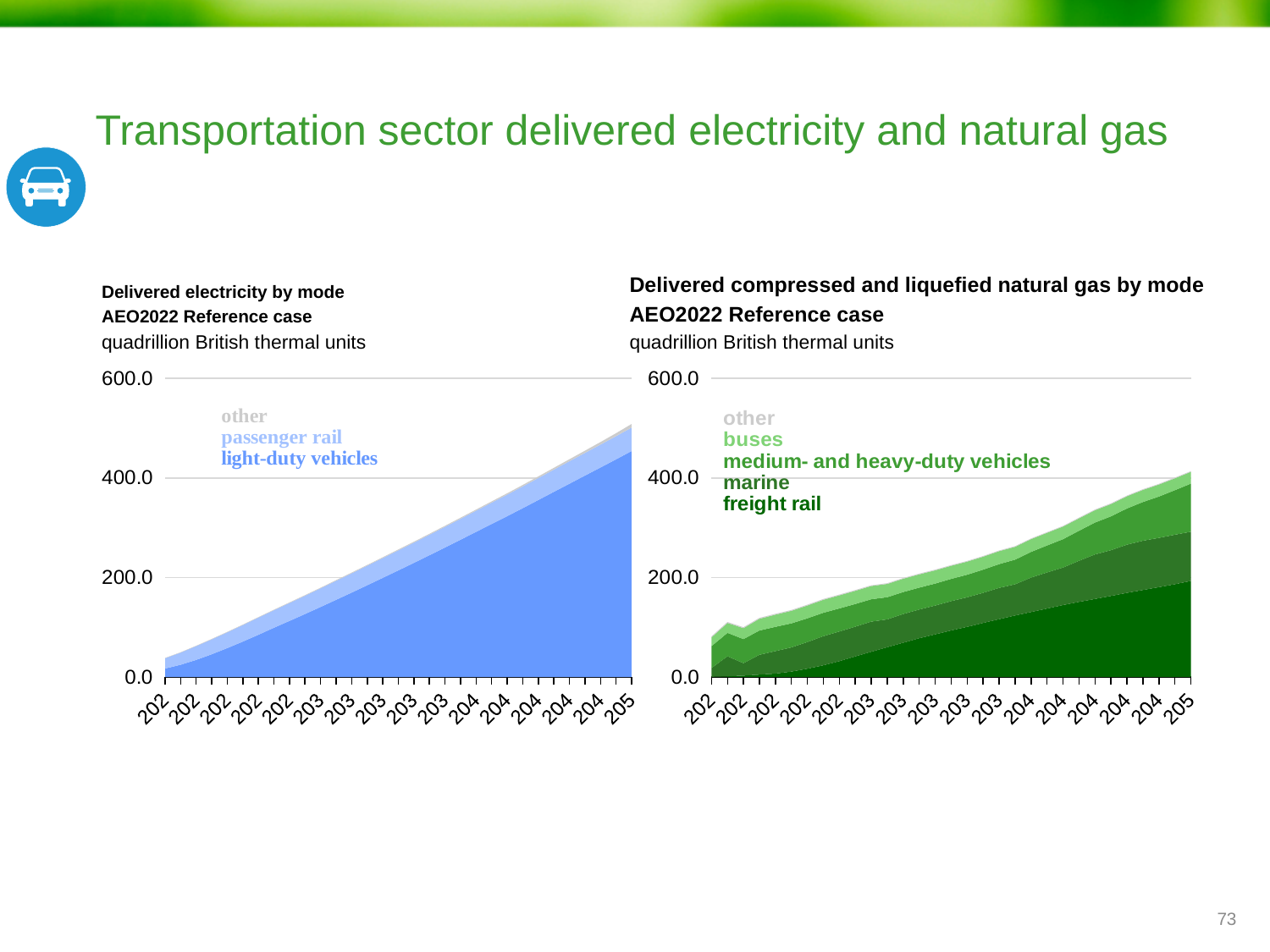
What kind of chart is the 'Delivered compressed and liquefied natural gas by mode' chart on the right? Stacked area chart In the left chart, 'Delivered electricity by mode', is the total at the final year greater or less than 400.0? greater In the left chart, 'Delivered electricity by mode', is the total at the first year greater or less than 200.0? less In the left chart, 'Delivered electricity by mode', which mode accounts for the largest share of delivered electricity? light-duty vehicles What unit is used on the y axis of both charts? quadrillion British thermal units What kind of chart is the 'Delivered electricity by mode' chart on the left? Stacked area chart In the right chart, 'Delivered compressed and liquefied natural gas by mode', is the total at the final year greater or less than 200.0? greater In the right chart, 'Delivered compressed and liquefied natural gas by mode', which mode accounts for the largest share of delivered natural gas? freight rail In the left chart, 'Delivered electricity by mode', does total delivered electricity rise or fall over time? Rise How many series does the legend of the left chart, 'Delivered electricity by mode', list? 3 How many series does the legend of the right chart, 'Delivered compressed and liquefied natural gas by mode', list? 5 In the right chart, 'Delivered compressed and liquefied natural gas by mode', does total delivered natural gas rise or fall over time? Rise